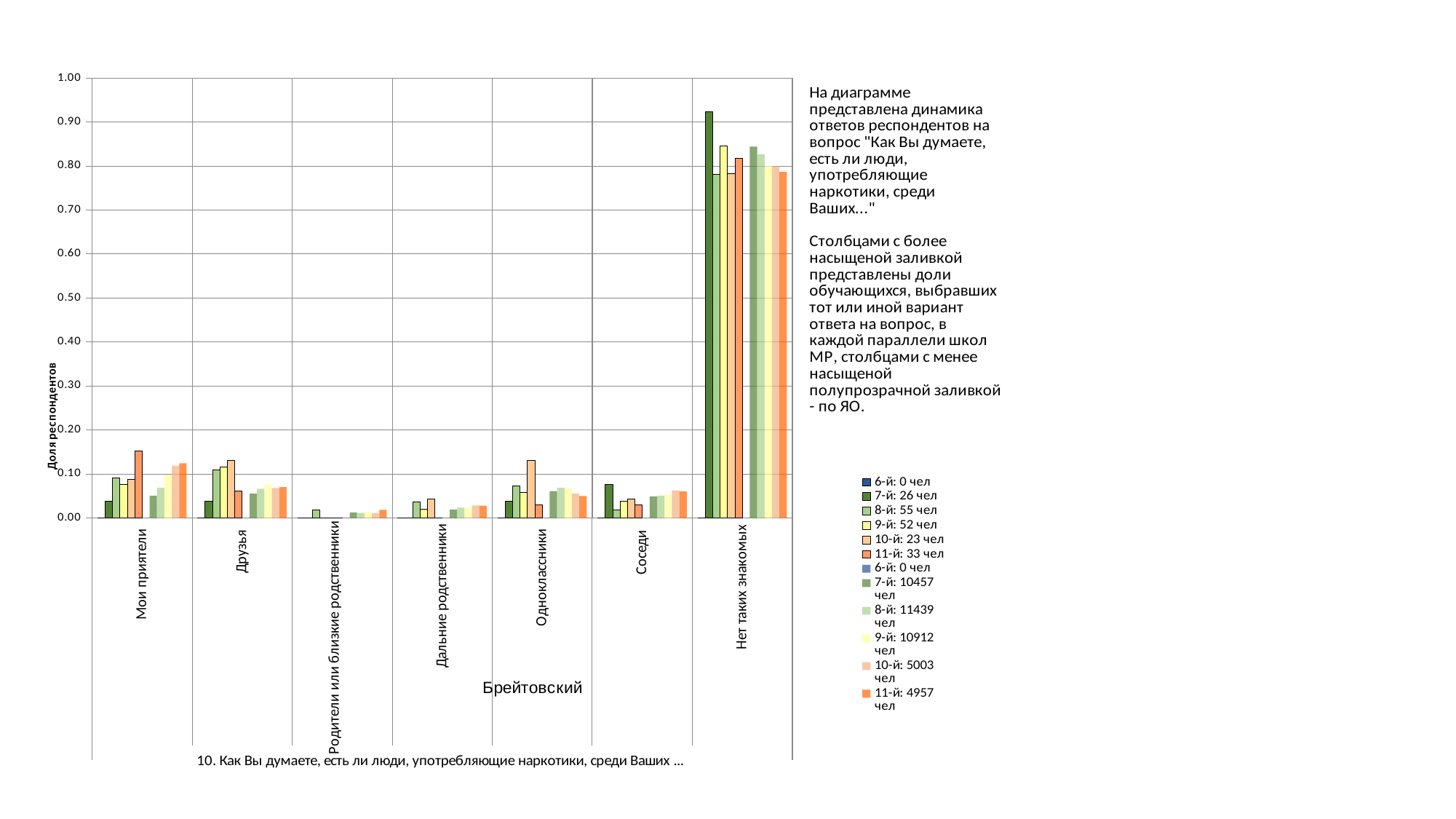
Is the value for the series "11-й: 33 чел" in the category "Мои приятели" greater or less than 0.10? greater How many series does the chart's legend list? 12 Is the value for the series "7-й: 26 чел" in the category "Нет таких знакомых" greater or less than 0.90? greater Is the value for the series "7-й: 26 чел" in the category "Соседи" greater or less than 0.10? less What kind of chart is shown on the slide? bar chart What is the title of the chart's vertical axis? Доля респондентов Which category has the highest bars in the chart? Нет таких знакомых In the category "Мои приятели", which series has the larger value: "11-й: 33 чел" or "7-й: 26 чел"? 11-й: 33 чел In the category "Нет таких знакомых", which series has the larger value: "7-й: 26 чел" or "8-й: 55 чел"? 7-й: 26 чел How many categories are shown along the x axis of the chart? 7 Which category has the lowest bars in the chart? Родители или близкие родственники